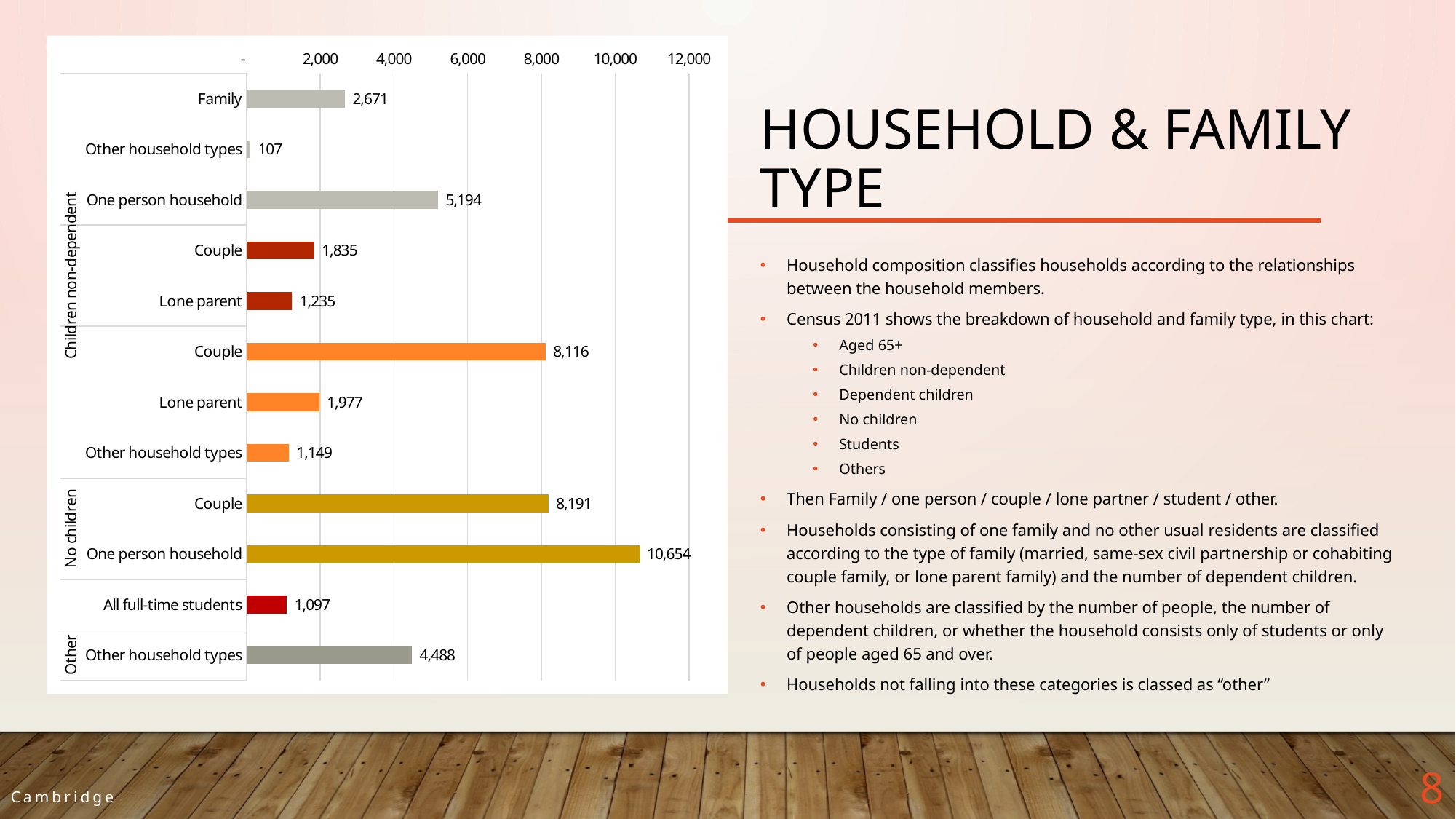
Which is larger: Other household types in the Other group or Family? Other household types in the Other group (4,488) In the No children group, what is the difference between One person household and Couple? 2,463 Which bar has the lowest value in the chart? Other household types (topmost group), 107 Is the value for Lone parent in the Children non-dependent group greater or less than 2,000? less What is the value for All full-time students? 1,097 What is the value of the Family bar in the chart? 2,671 Which bar has the highest value in the chart? One person household (No children), 10,654 How many bars are plotted in the chart? 12 What kind of chart is shown on the slide? Bar chart In the Children non-dependent group, what is the value for Lone parent? 1,235 In the Children non-dependent group, what is the value for Couple? 1,835 In the No children group, what is the value for One person household? 10,654